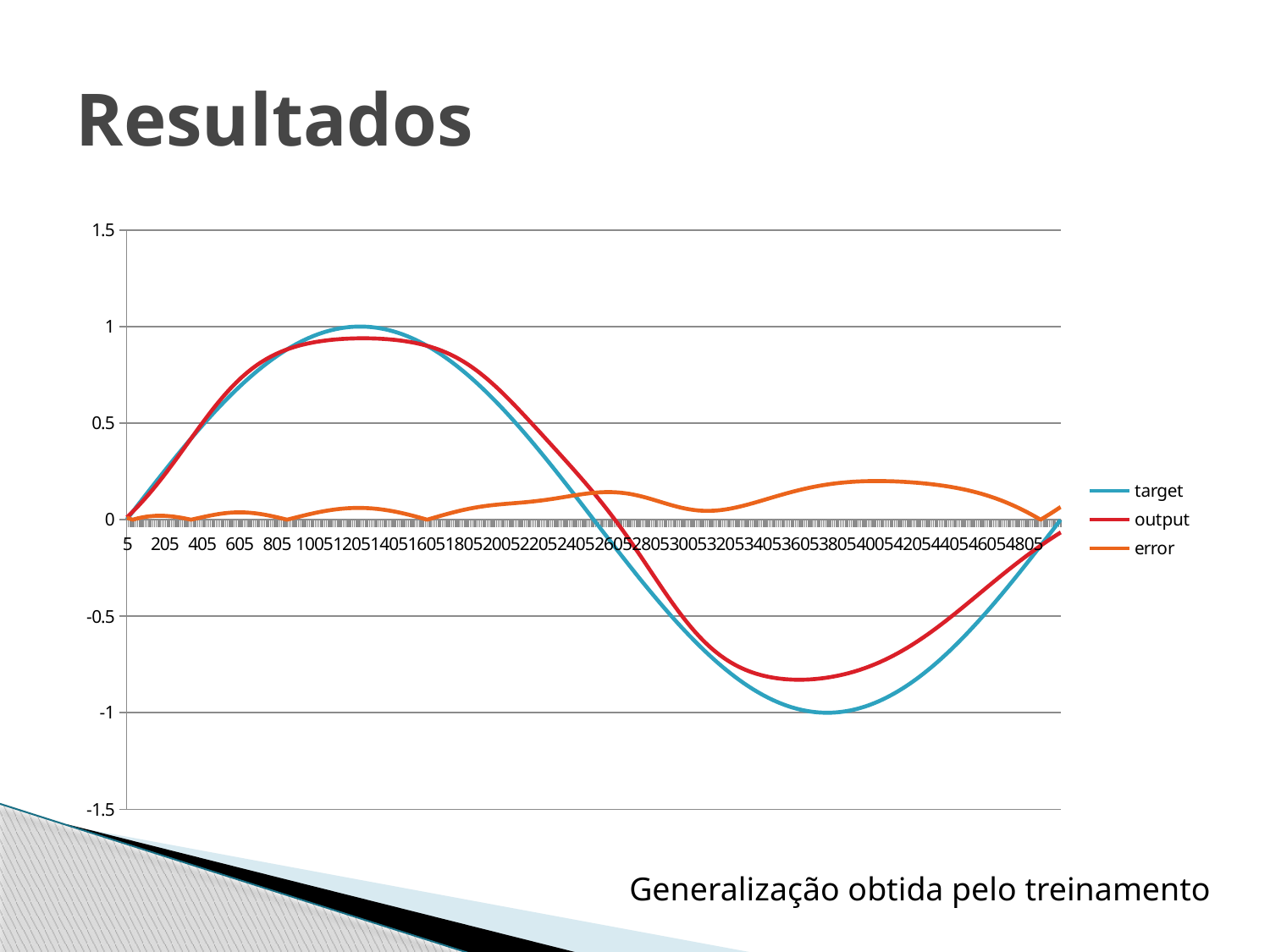
Around 3805, which series has the larger value, target or output? output Does the output series rise or fall between 1205 and 3605 on the x axis? fall Is the peak value of the target series greater or less than 0.5? greater Does the target series rise or fall between 5 and 1205 on the x axis? rise Is the value of the error series at 4005 greater or less than 0.5? less Is the value of the target series at 3805 greater or less than -0.5? less How many series does the legend list? 3 What kind of chart is shown on the slide? line chart Which colour is used for the error series? orange Around 1205, which series has the larger value, target or output? target What are the names of the series listed in the legend? target, output, error